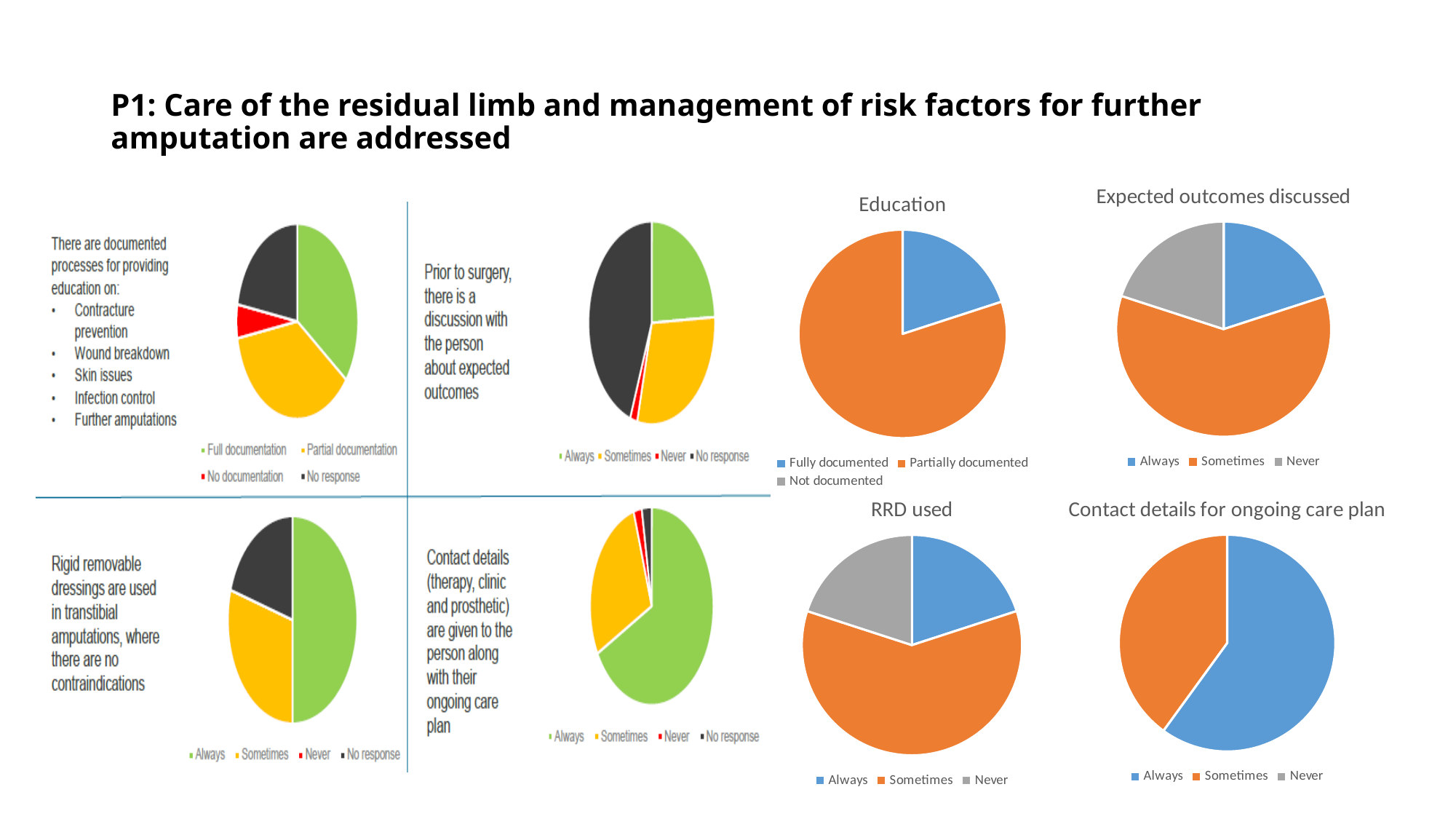
In the 'RRD used' chart, which category has the largest slice? Sometimes In the 'Expected outcomes discussed' chart, which category has the largest slice? Sometimes In the pie chart about the discussion prior to surgery about expected outcomes (top row, second from left), which category has the largest slice? No response How many entries does the legend of the 'RRD used' chart list? 3 In the 'Expected outcomes discussed' chart, which slice is larger, Always or Sometimes? Sometimes In the 'Contact details for ongoing care plan' chart, which slice is larger, Always or Sometimes? Always What kind of chart is the 'Education' chart? pie chart How many entries does the legend of the 'Education' chart list? 3 In the top-left pie chart about documented processes for providing education, which category has the smallest slice? No documentation